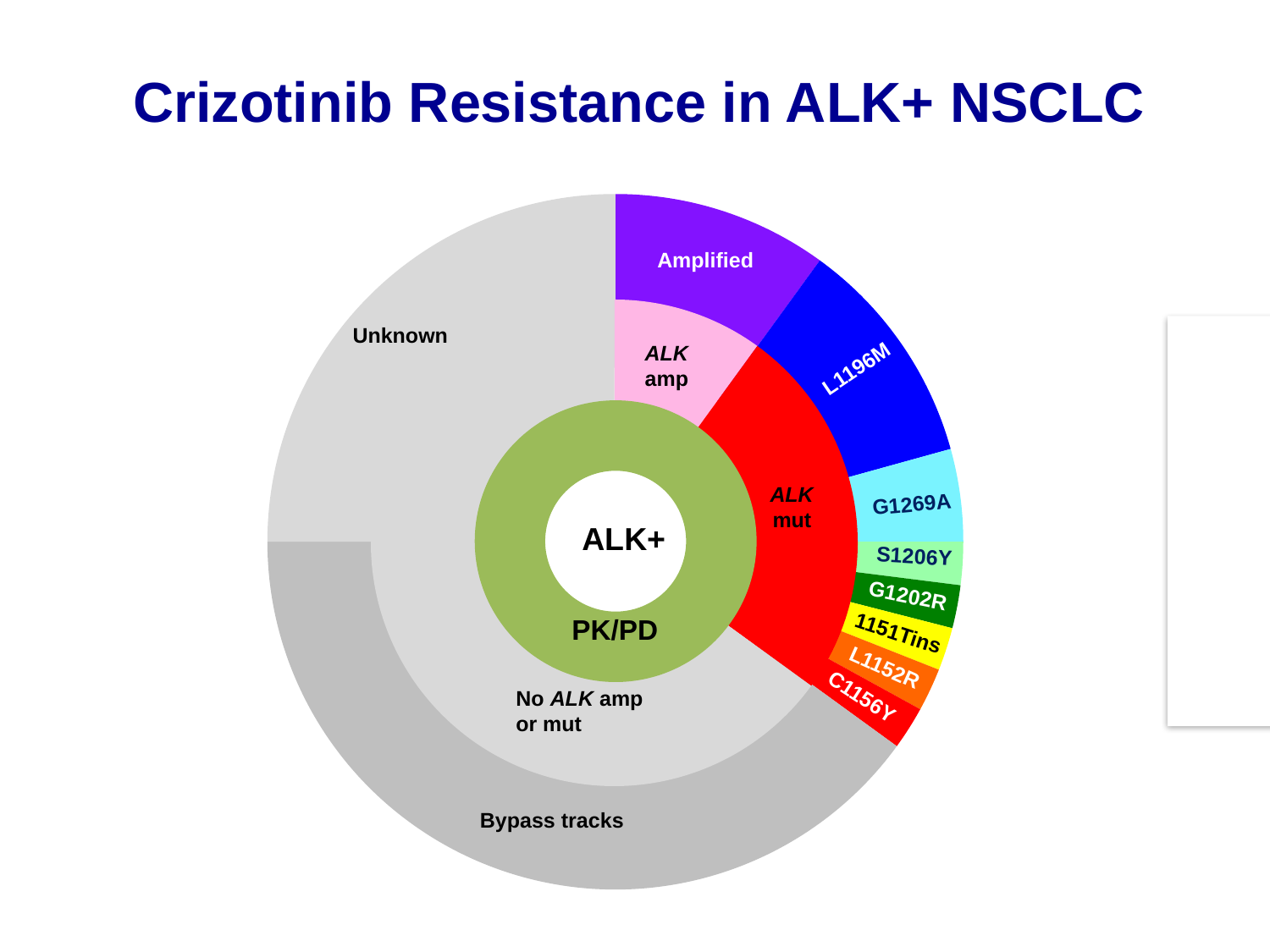
Which segment is larger, L1196M or G1269A? L1196M What label appears in the centre of the chart? ALK+ What is the title of the slide? Crizotinib Resistance in ALK+ NSCLC How many specific ALK mutations are labelled in the outer ring of the chart? 7 Which segment is larger, ALK mut or ALK amp? ALK mut How many categories are shown in the middle ring of the chart (ALK amp, ALK mut, No ALK amp or mut)? 3 Which labelled ALK mutation occupies the largest segment in the outer ring? L1196M Which category in the middle ring occupies the largest share of the chart? No ALK amp or mut Which segment is larger, Bypass tracks or Unknown? Bypass tracks What kind of chart is shown on the slide? Donut chart